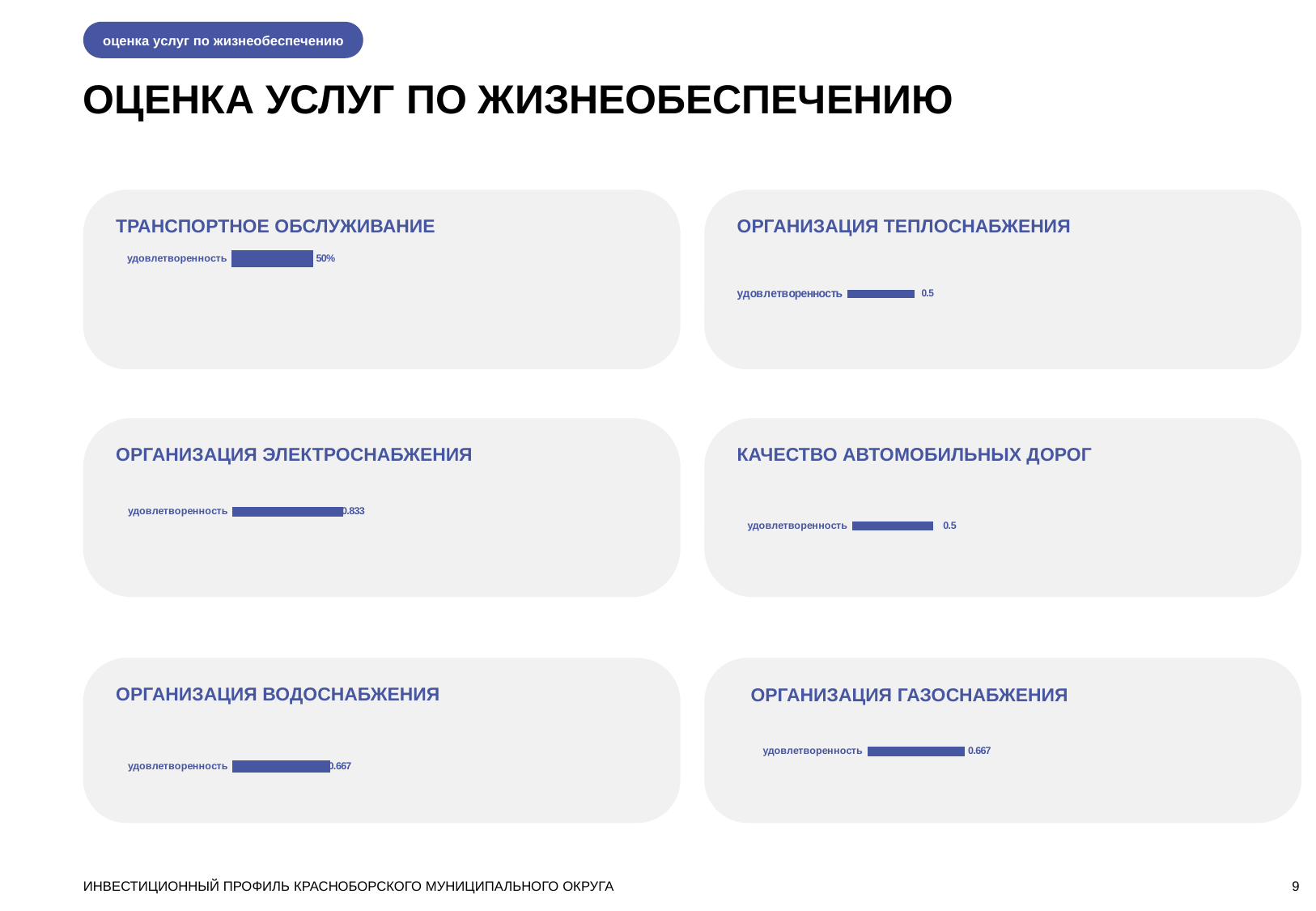
In the chart under "КАЧЕСТВО АВТОМОБИЛЬНЫХ ДОРОГ", what is the value shown for удовлетворенность? 0.5 How many bars are plotted in the chart under "ОРГАНИЗАЦИЯ ВОДОСНАБЖЕНИЯ"? 1 What is the difference between the удовлетворенность value in the "ОРГАНИЗАЦИЯ ЭЛЕКТРОСНАБЖЕНИЯ" chart and the one in the "ОРГАНИЗАЦИЯ ГАЗОСНАБЖЕНИЯ" chart? 0.166 In the chart under "ОРГАНИЗАЦИЯ ЭЛЕКТРОСНАБЖЕНИЯ", what is the value shown for удовлетворенность? 0.833 In the chart under "ТРАНСПОРТНОЕ ОБСЛУЖИВАНИЕ", what is the value shown for удовлетворенность? 50% What kind of chart is shown under "ОРГАНИЗАЦИЯ ЭЛЕКТРОСНАБЖЕНИЯ"? Bar chart In the chart under "ОРГАНИЗАЦИЯ ГАЗОСНАБЖЕНИЯ", what is the value shown for удовлетворенность? 0.667 In the chart under "ОРГАНИЗАЦИЯ ВОДОСНАБЖЕНИЯ", what is the value shown for удовлетворенность? 0.667 Which is larger: the удовлетворенность value in the "ОРГАНИЗАЦИЯ ЭЛЕКТРОСНАБЖЕНИЯ" chart or in the "ОРГАНИЗАЦИЯ ВОДОСНАБЖЕНИЯ" chart? ОРГАНИЗАЦИЯ ЭЛЕКТРОСНАБЖЕНИЯ What is the category label of the bar in the chart under "КАЧЕСТВО АВТОМОБИЛЬНЫХ ДОРОГ"? удовлетворенность In the chart under "ОРГАНИЗАЦИЯ ТЕПЛОСНАБЖЕНИЯ", what is the value shown for удовлетворенность? 0.5 How many separate charts are shown on the slide? 6